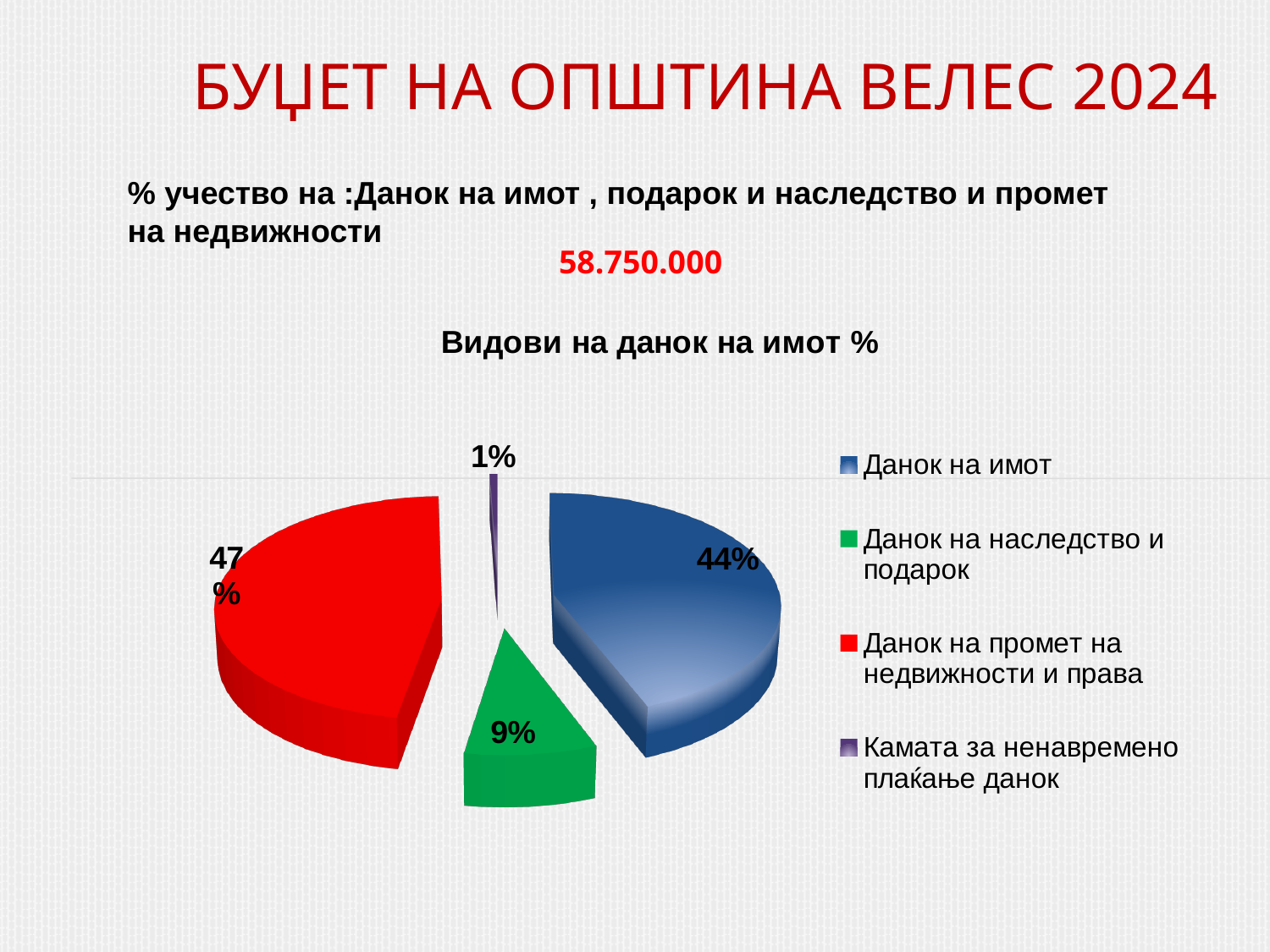
What share of the pie does Данок на промет на недвижности и права have? 47% What colour is the slice for Данок на наследство и подарок? green Which category has the largest slice of the pie? Данок на промет на недвижности и права What is the difference in percentage points between Данок на промет на недвижности и права and Данок на имот? 3 What share of the pie does Данок на наследство и подарок have? 9% Which is larger: the share for Данок на имот or the share for Данок на наследство и подарок? Данок на имот How many categories does the pie chart show? 4 What share of the pie does Камата за ненавремено плаќање данок have? 1% What share of the pie does Данок на имот have? 44% What is the title of the pie chart? Видови на данок на имот % What type of chart is shown on the slide? pie chart Which category has the smallest slice of the pie? Камата за ненавремено плаќање данок